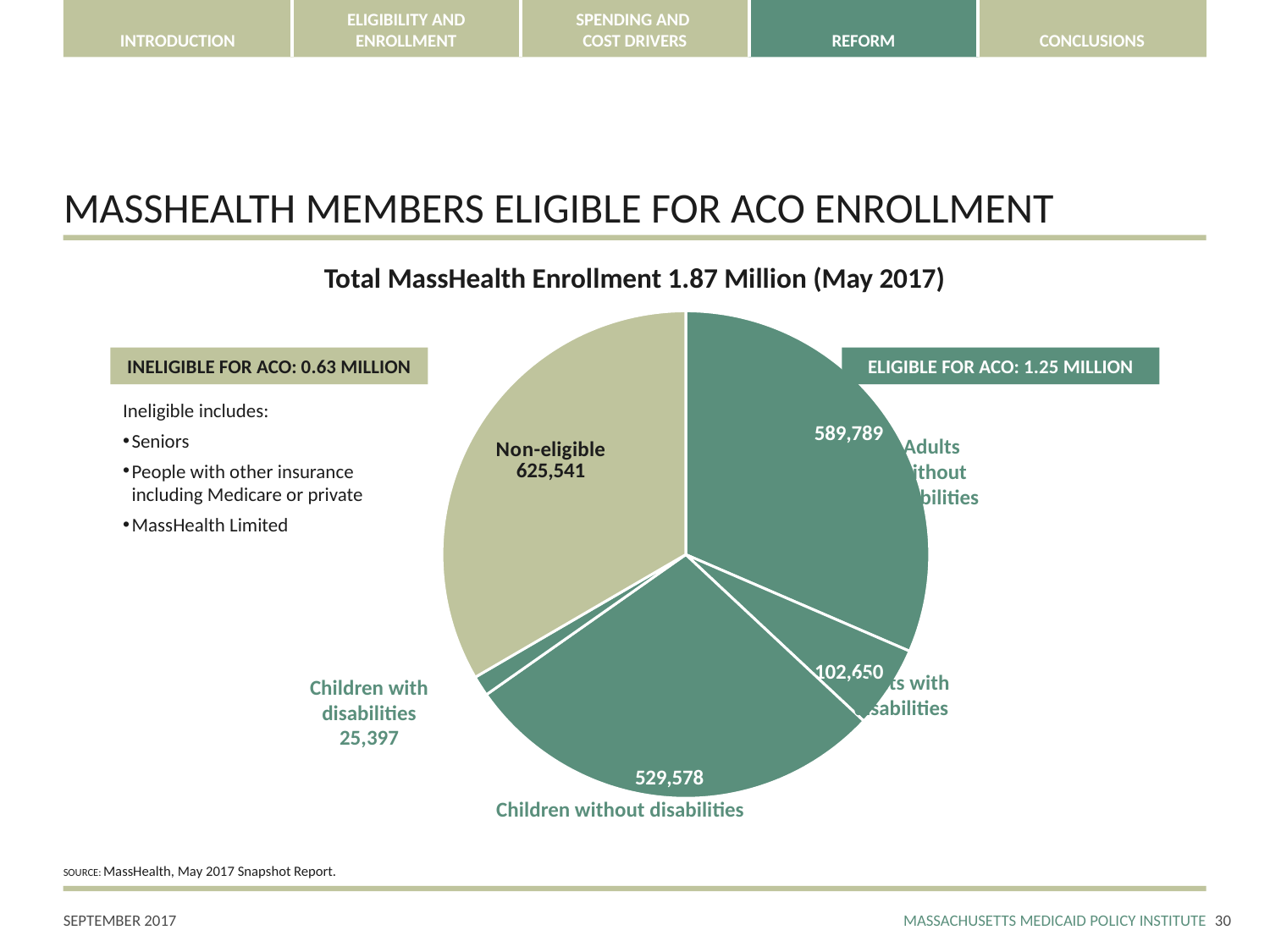
Which is larger, Non-eligible or Children without disabilities? Non-eligible What is the difference between Children without disabilities and Children with disabilities? 504,181 What is the difference between the Non-eligible value and the Children without disabilities value? 95,963 What is the value for the Non-eligible slice? 625,541 What is the value for Children with disabilities? 25,397 Which slice of the pie chart has the smallest value? Children with disabilities What is the value for Children without disabilities? 529,578 What kind of chart is shown on the slide? Pie chart Which slice of the pie chart has the largest value? Non-eligible What is the value for Adults without disabilities? 589,789 How many slices does the pie chart have? 5 What is the title of the pie chart? Total MassHealth Enrollment 1.87 Million (May 2017)